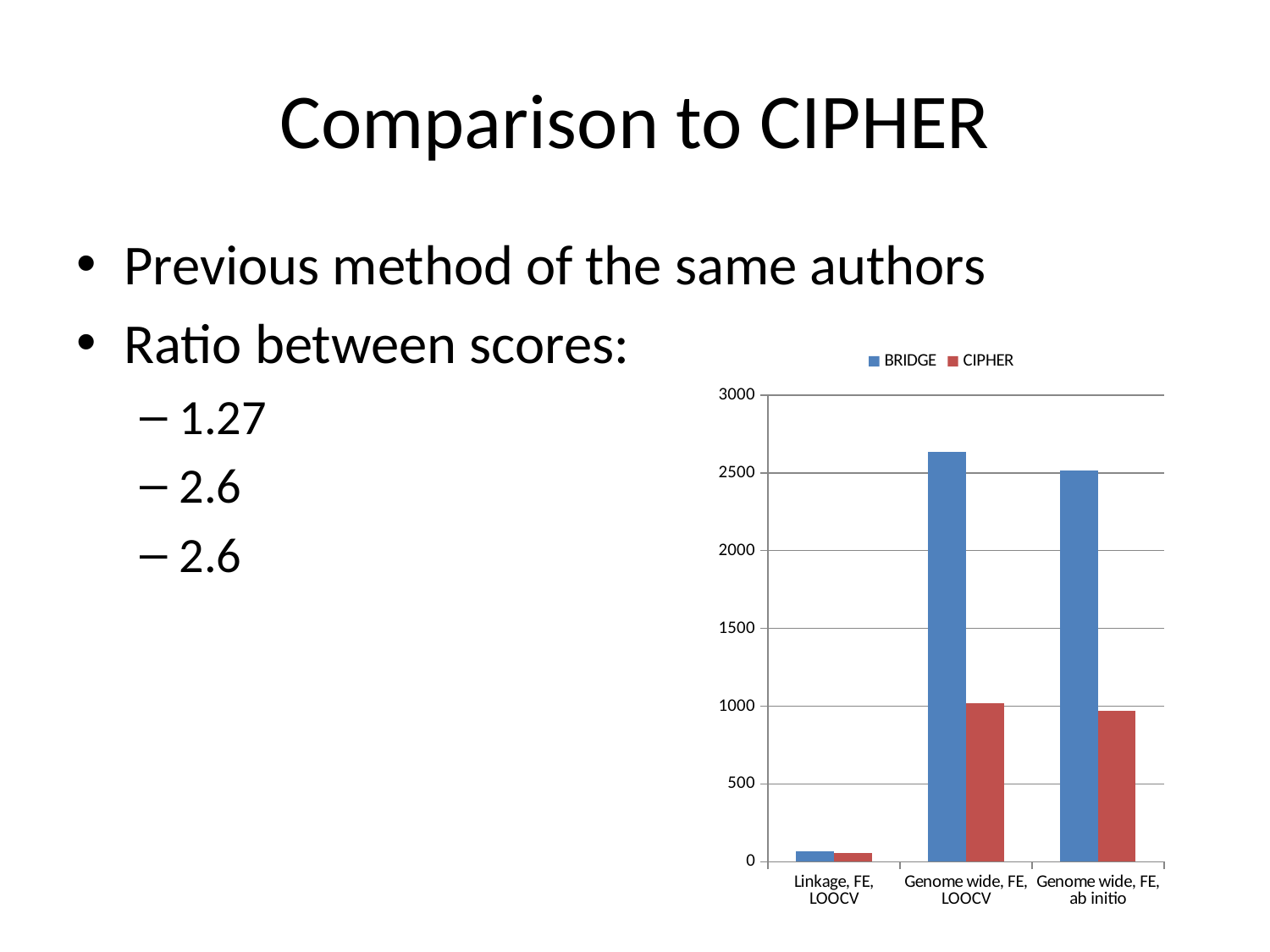
Which category has the highest BRIDGE value? Genome wide, FE, LOOCV What are the two series named in the legend? BRIDGE and CIPHER What kind of chart is shown on the slide? bar chart How many series does the legend list? 2 Is the BRIDGE value for Linkage, FE, LOOCV greater or less than 500? less Which category has the lowest CIPHER value? Linkage, FE, LOOCV For Genome wide, FE, LOOCV, which series has the larger value, BRIDGE or CIPHER? BRIDGE How many categories are shown on the x axis? 3 Which category has the lowest BRIDGE value? Linkage, FE, LOOCV Which series is shown in blue in the chart? BRIDGE